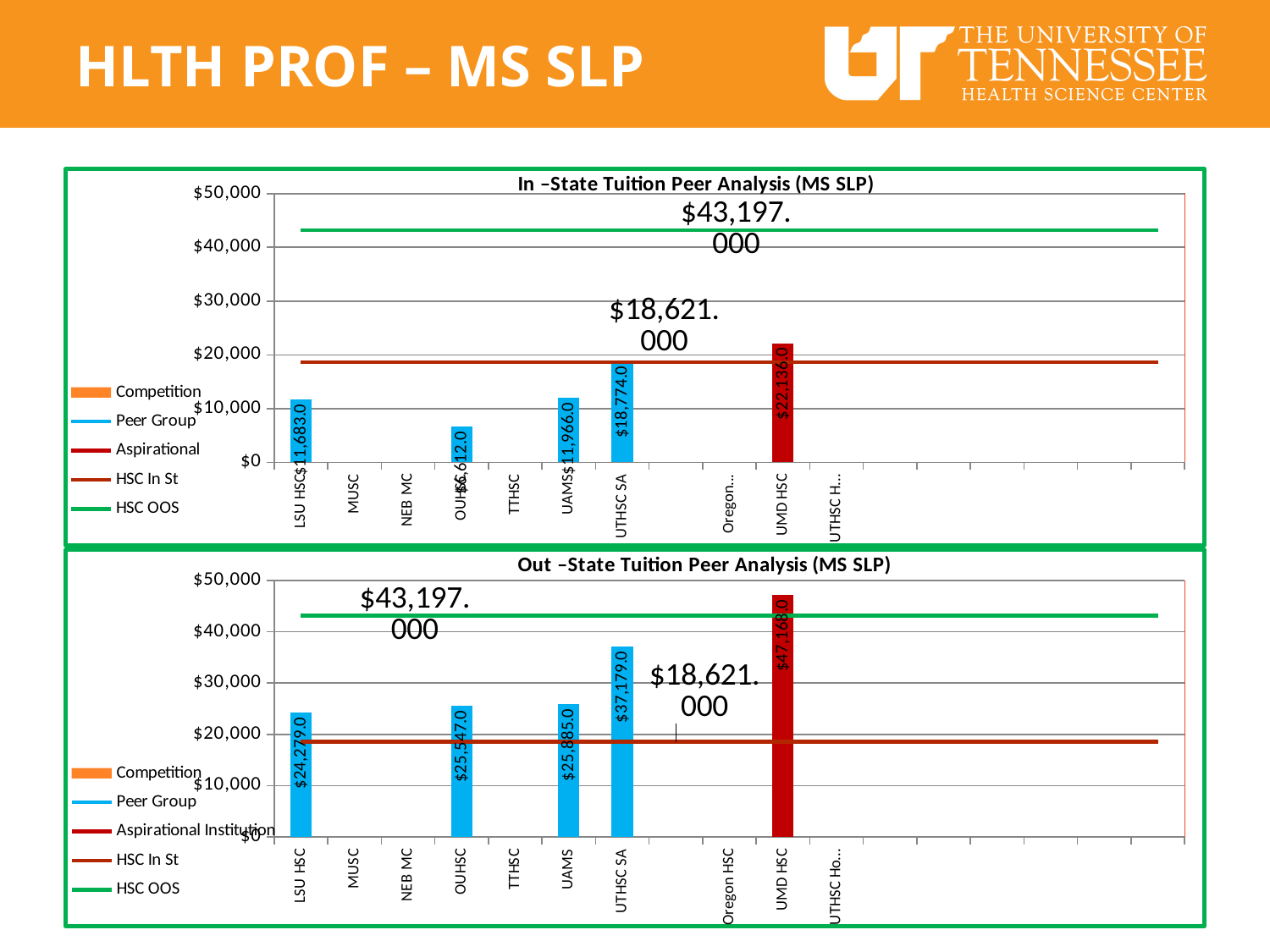
In the Out-State Tuition Peer Analysis chart, what value is labelled on the HSC OOS line? $43,197.000 In the Out-State Tuition Peer Analysis chart, which institution has the highest bar? UMD HSC What kind of chart is the Out-State Tuition Peer Analysis chart? bar chart How many entries does the legend of the In-State Tuition Peer Analysis chart list? 5 In the Out-State Tuition Peer Analysis chart, which is larger, the value for LSU HSC or the value for UTHSC SA? UTHSC SA In the In-State Tuition Peer Analysis chart, is the value for LSU HSC greater or less than $20,000? less In the Out-State Tuition Peer Analysis chart, what is the value for UMD HSC? $47,168.0 In the In-State Tuition Peer Analysis chart, what is the difference between the UMD HSC value and the UTHSC SA value? $3,362.0 In the Out-State Tuition Peer Analysis chart, what is the difference between the UMD HSC value and the UTHSC SA value? $9,989.0 In the In-State Tuition Peer Analysis chart, what is the value for UTHSC SA? $18,774.0 In the In-State Tuition Peer Analysis chart, which institution has the highest bar? UMD HSC In the In-State Tuition Peer Analysis chart, which institution has the lowest bar? OUHSC